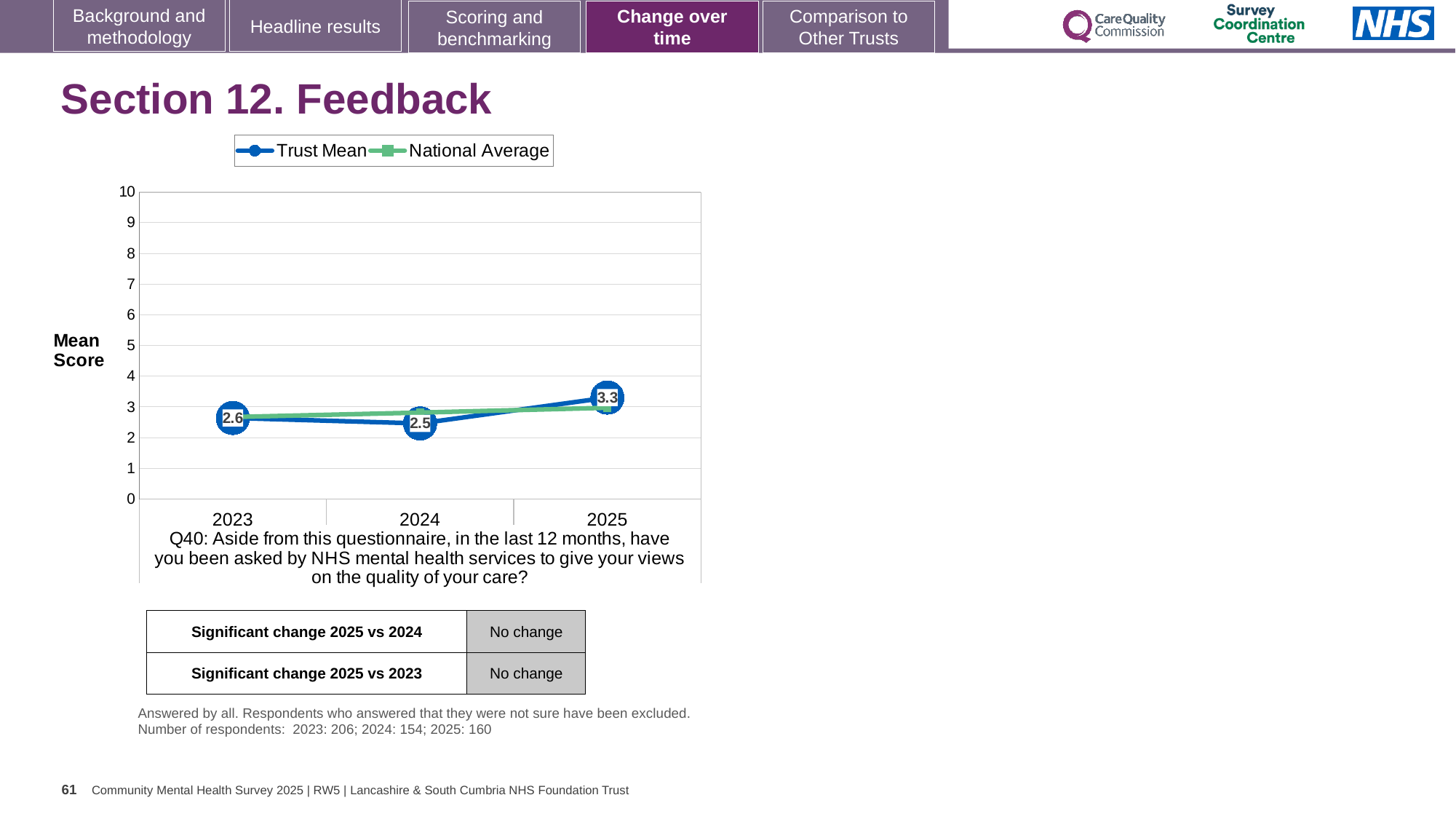
What kind of chart is shown? line chart Which is larger, the Trust Mean in 2023 or in 2025? 2025 How many years are shown on the x axis? 3 Is the National Average value for 2025 greater or less than 4? less What is the Trust Mean score for 2024? 2.5 What is the Trust Mean score for 2023? 2.6 In which year is the Trust Mean lowest? 2024 How many series does the legend list? 2 What is the Trust Mean score for 2025? 3.3 What is the difference between the Trust Mean in 2025 and in 2024? 0.8 What is the label on the y axis? Mean Score In which year is the Trust Mean highest? 2025